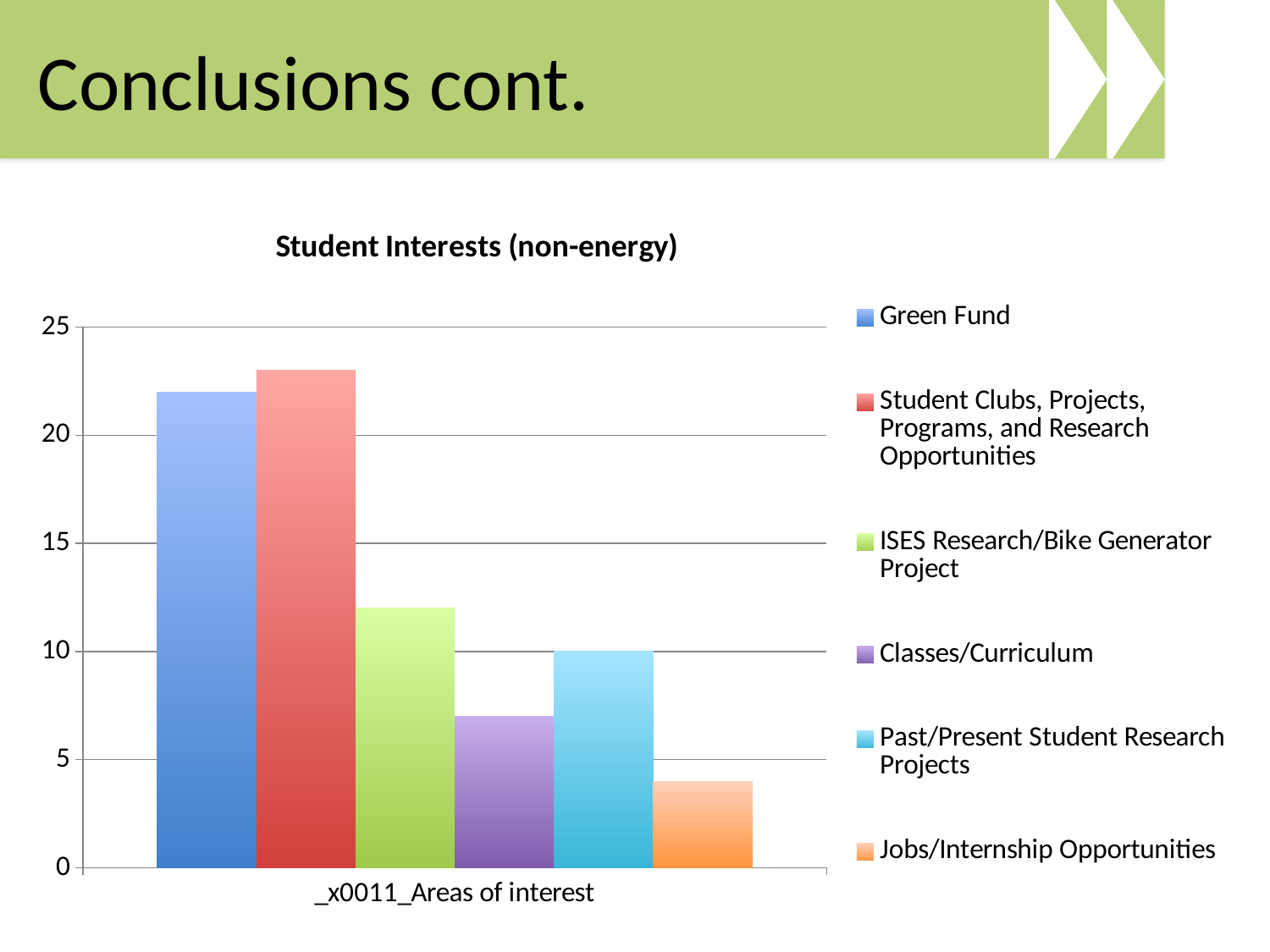
Which is larger, the value for Green Fund or the value for Past/Present Student Research Projects? Green Fund What is the value for Past/Present Student Research Projects? 10 Is the value for ISES Research/Bike Generator Project greater or less than 15? less Which series has the lowest value? Jobs/Internship Opportunities Which series has the highest value? Student Clubs, Projects, Programs, and Research Opportunities What is the title of the chart? Student Interests (non-energy) Is the value for Jobs/Internship Opportunities greater or less than 5? less Which is larger, the value for ISES Research/Bike Generator Project or the value for Classes/Curriculum? ISES Research/Bike Generator Project Is the value for Green Fund greater or less than 20? greater How many series does the legend list? 6 What kind of chart is shown on the slide? bar chart